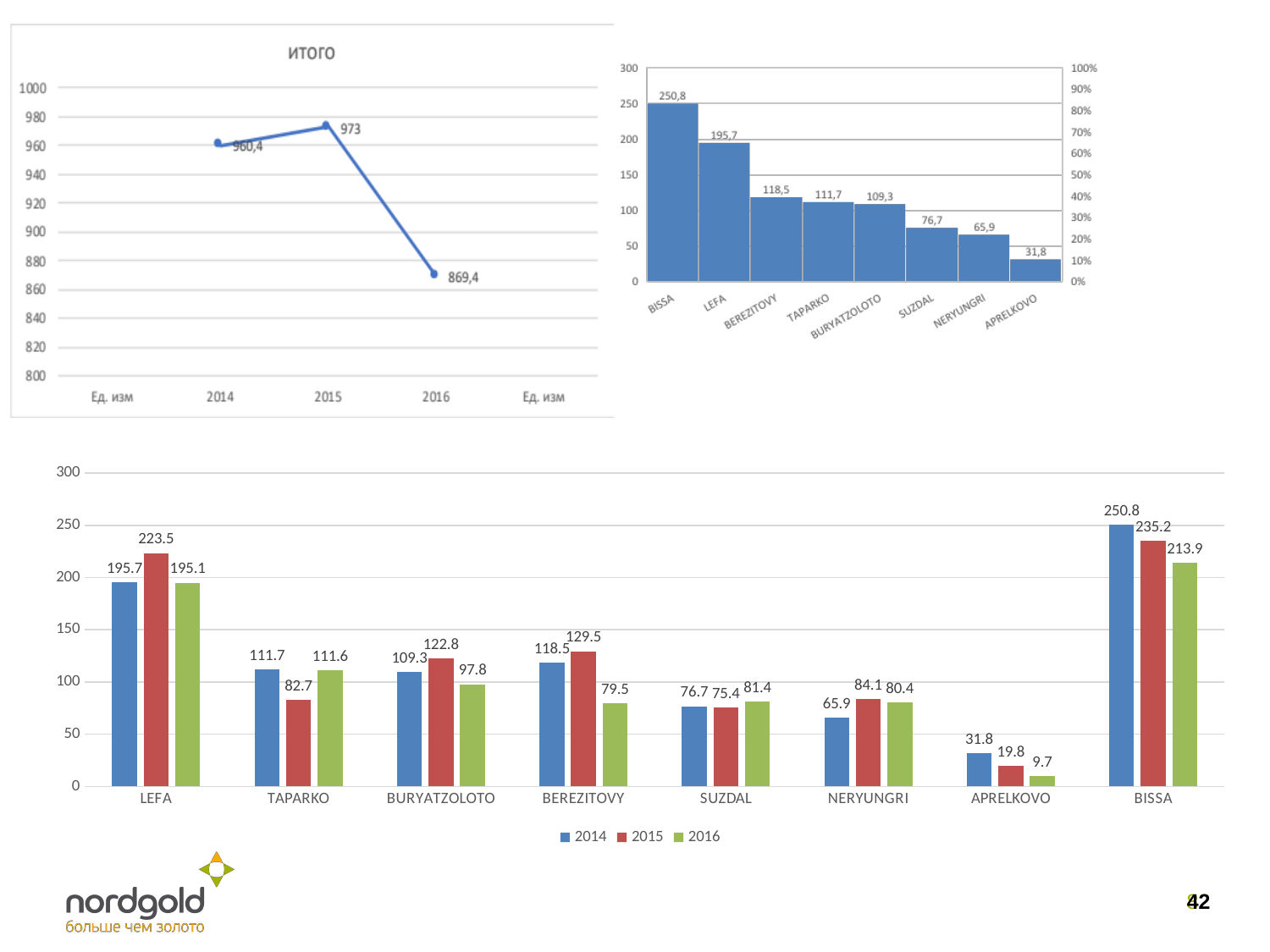
In the bottom chart, what is the 2015 value for TAPARKO? 82.7 In the top-right bar chart, what is the value for BEREZITOVY? 118,5 In the top-left chart titled ИТОГО, what is the difference between the 2015 and 2016 values? 103,6 In the top-left chart titled ИТОГО, what is the value for 2015? 973 In the bottom chart, which is larger for NERYUNGRI: the 2014 value or the 2015 value? 2015 In the bottom chart, what is the difference between the 2014 and 2016 values for BISSA? 36.9 In the top-right bar chart, how many categories are shown? 8 In the top-right bar chart, which category has the highest value? BISSA In the top-left chart titled ИТОГО, which year has the lowest value? 2016 In the bottom chart, how many series does the legend list? 3 In the top-left chart titled ИТОГО, what is the value for 2016? 869,4 In the top-left chart titled ИТОГО, what kind of chart is shown? line chart